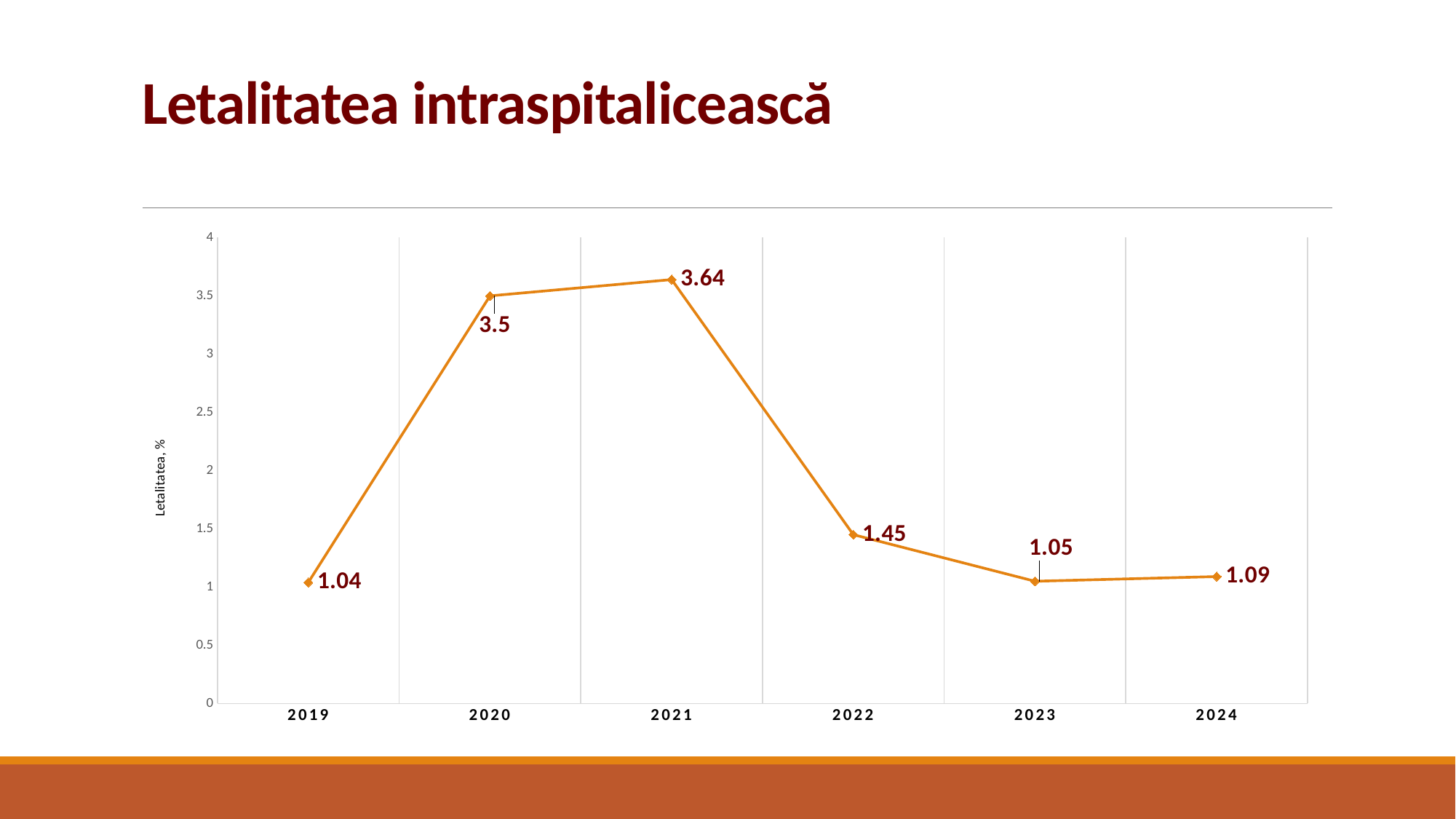
What is the difference between the values for 2020 and 2019? 2.46 What is the value for 2019? 1.04 Which year has the highest value? 2021 Is the value for 2020 greater or less than 3? greater What kind of chart is shown on the slide? line chart What is the difference between the values for 2021 and 2022? 2.19 What is the label of the vertical axis? Letalitatea, % Which year has the lowest value? 2019 What is the value for 2023? 1.05 Which is larger, the value for 2022 or the value for 2024? 2022 How many years are plotted on the chart? 6 What is the value for 2021? 3.64